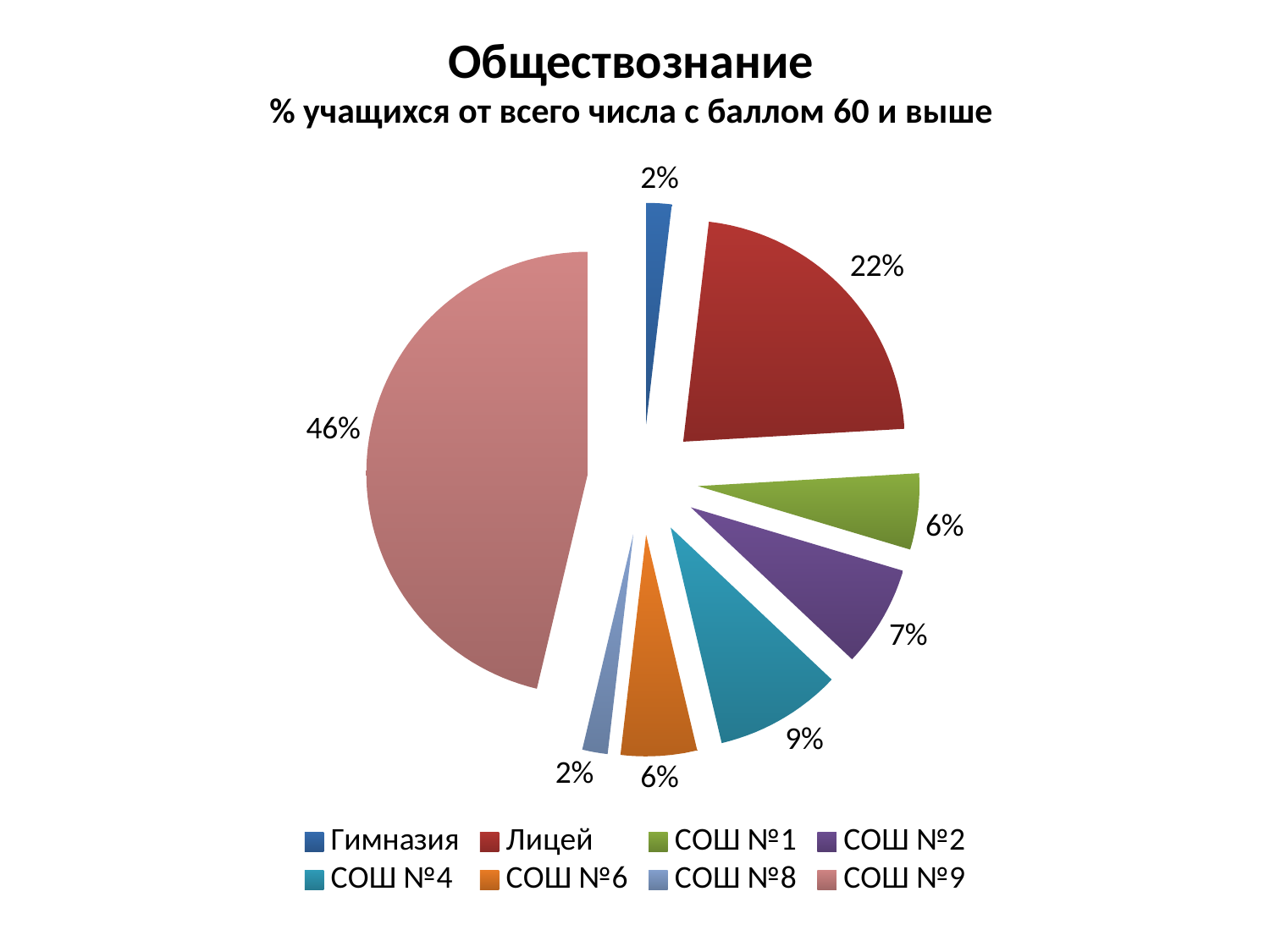
Which category has the largest slice of the pie? СОШ №9 Which category has the larger value, Лицей or СОШ №4? Лицей How many categories does the legend list? 8 What is the title of the chart? Обществознание What is the difference between the values for СОШ №9 and Лицей? 24% What is the value for СОШ №2? 7% What kind of chart is shown on the slide? pie chart What is the difference between the values for СОШ №4 and СОШ №1? 3% What is the value for СОШ №4? 9% What is the value for Лицей? 22% What share of the pie does СОШ №9 have? 46% Which two categories share the smallest value of 2%? Гимназия and СОШ №8